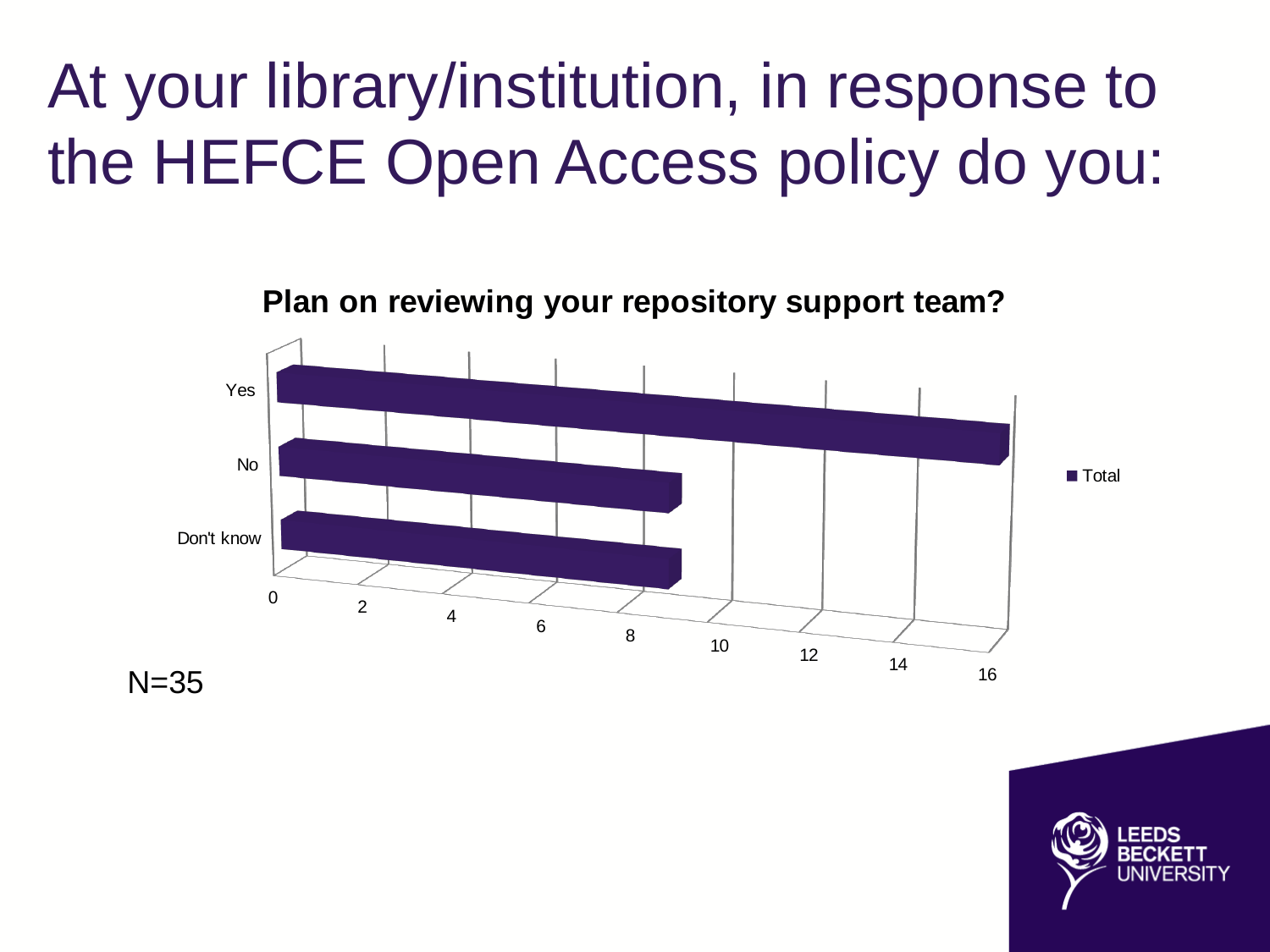
What is the title of the chart? Plan on reviewing your repository support team? Is the value for Yes greater or less than 12? greater Is the value for Don't know greater or less than 4? greater Which is larger, the value for Don't know or the value for Yes? Yes What series name appears in the chart's legend? Total Which is larger, the value for Yes or the value for No? Yes Is the value for No greater or less than 6? greater What kind of chart is shown on the slide? bar chart Which category has the highest value in the chart? Yes How many categories are plotted in the chart? 3 How many series does the chart's legend list? 1